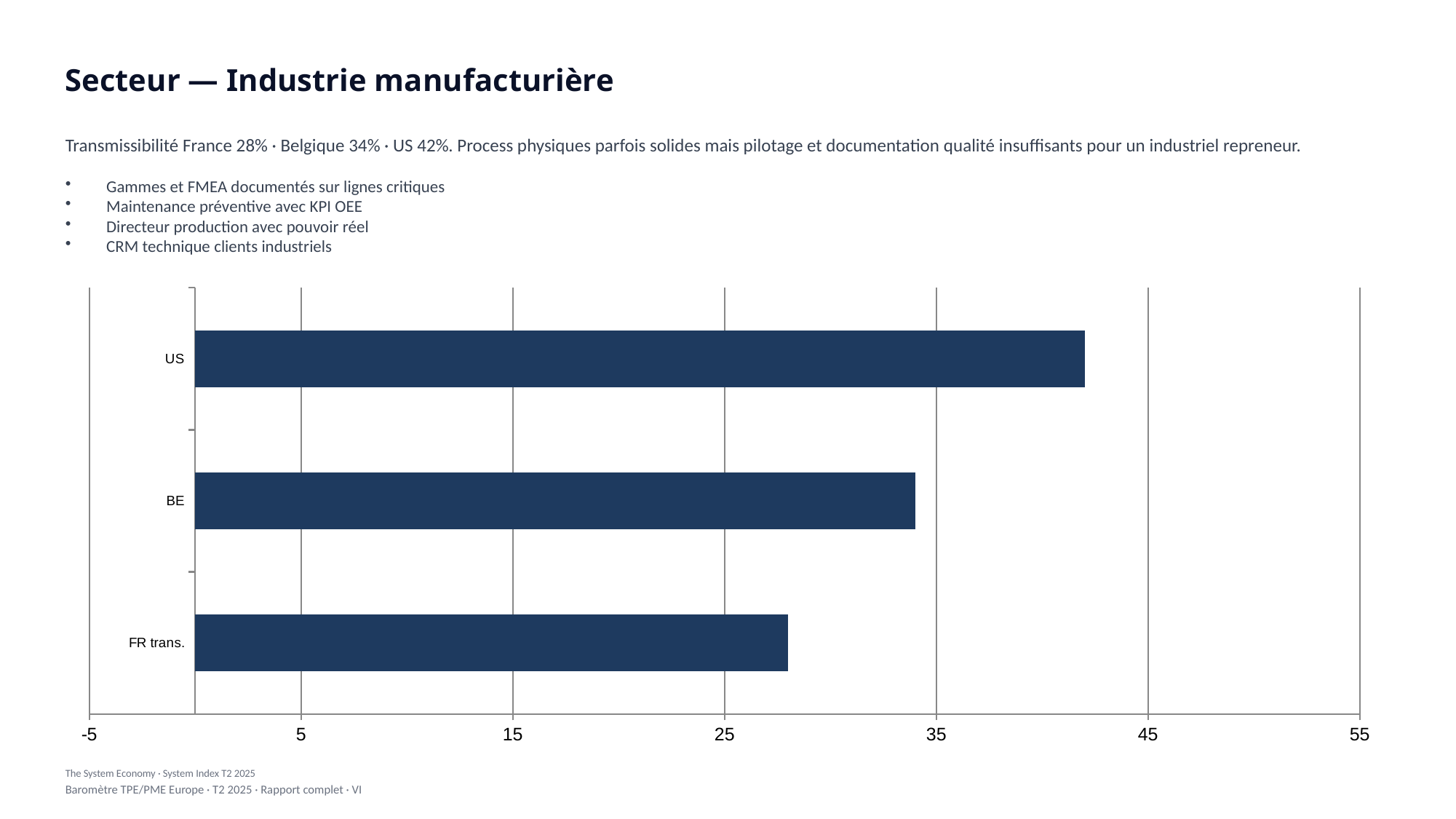
Which category has the lowest value in the chart? FR trans. Which is larger, the value for BE or the value for FR trans.? BE How many categories are plotted in the chart? 3 Which category has the highest value in the chart? US Is the value for US greater or less than 45? less Is the value for BE greater or less than 25? greater Is the value for US greater or less than 35? greater According to the slide text, what is the transmissibility value for Belgique? 34% What is the highest value shown on the horizontal axis of the chart? 55 What kind of chart is shown on the slide? bar chart According to the slide text, what is the transmissibility value for US? 42%